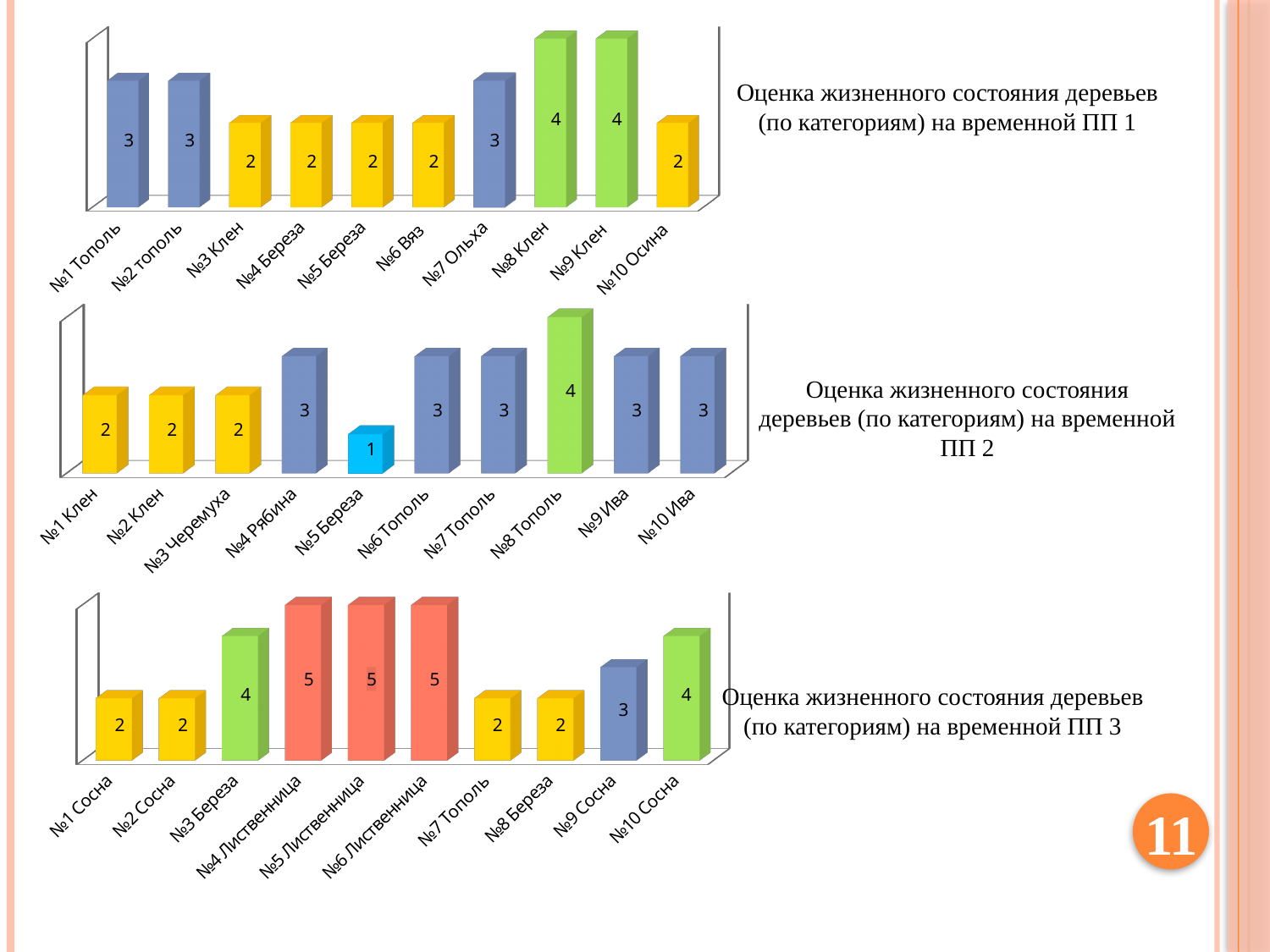
How many categories are shown in the top chart (временной ПП 1)? 10 In the top chart (временной ПП 1), what is the difference between the values for №8 Клен and №3 Клен? 2 In the middle chart (временной ПП 2), what is the value for №4 Рябина? 3 In the top chart (временной ПП 1), what is the value for №10 Осина? 2 In the bottom chart (временной ПП 3), which is larger, the value for №3 Береза or the value for №7 Тополь? №3 Береза How many charts are shown on the slide? 3 What type of chart is the middle chart (временной ПП 2)? Bar chart In the bottom chart (временной ПП 3), what is the difference between the values for №4 Лиственница and №1 Сосна? 3 In the top chart (временной ПП 1), what is the value for №7 Ольха? 3 In the middle chart (временной ПП 2), which category has the highest value? №8 Тополь In the bottom chart (временной ПП 3), what is the value for №9 Сосна? 3 In the middle chart (временной ПП 2), which category has the lowest value? №5 Береза